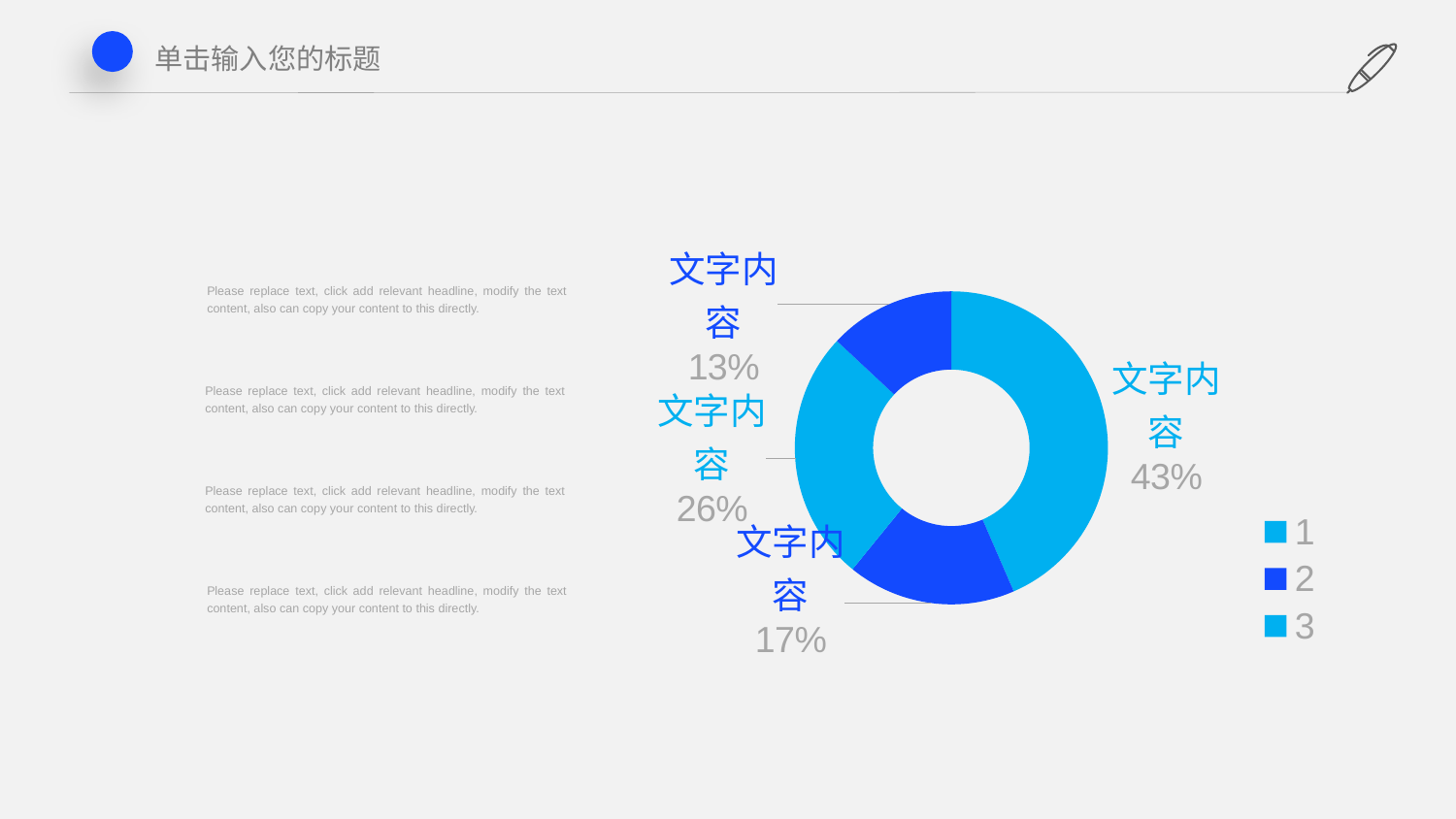
What percentage is labelled on the large slice on the right side of the doughnut chart? 43% What percentage is labelled on the slice at the bottom of the doughnut chart? 17% Which is larger: the slice labelled 26% or the slice labelled 17%? 26% What are the entries listed in the chart legend? 1, 2, 3 What is the largest percentage shown on the doughnut chart? 43% How many slices does the doughnut chart have? 4 What is the difference in percentage points between the largest slice (43%) and the smallest slice (13%)? 30 What percentage is labelled on the slice at the top-left of the doughnut chart? 13% What is the smallest percentage shown on the doughnut chart? 13% How many entries does the chart legend list? 3 What kind of chart is shown on the slide? doughnut chart What is the sum of the four percentage labels shown on the doughnut chart? 99%